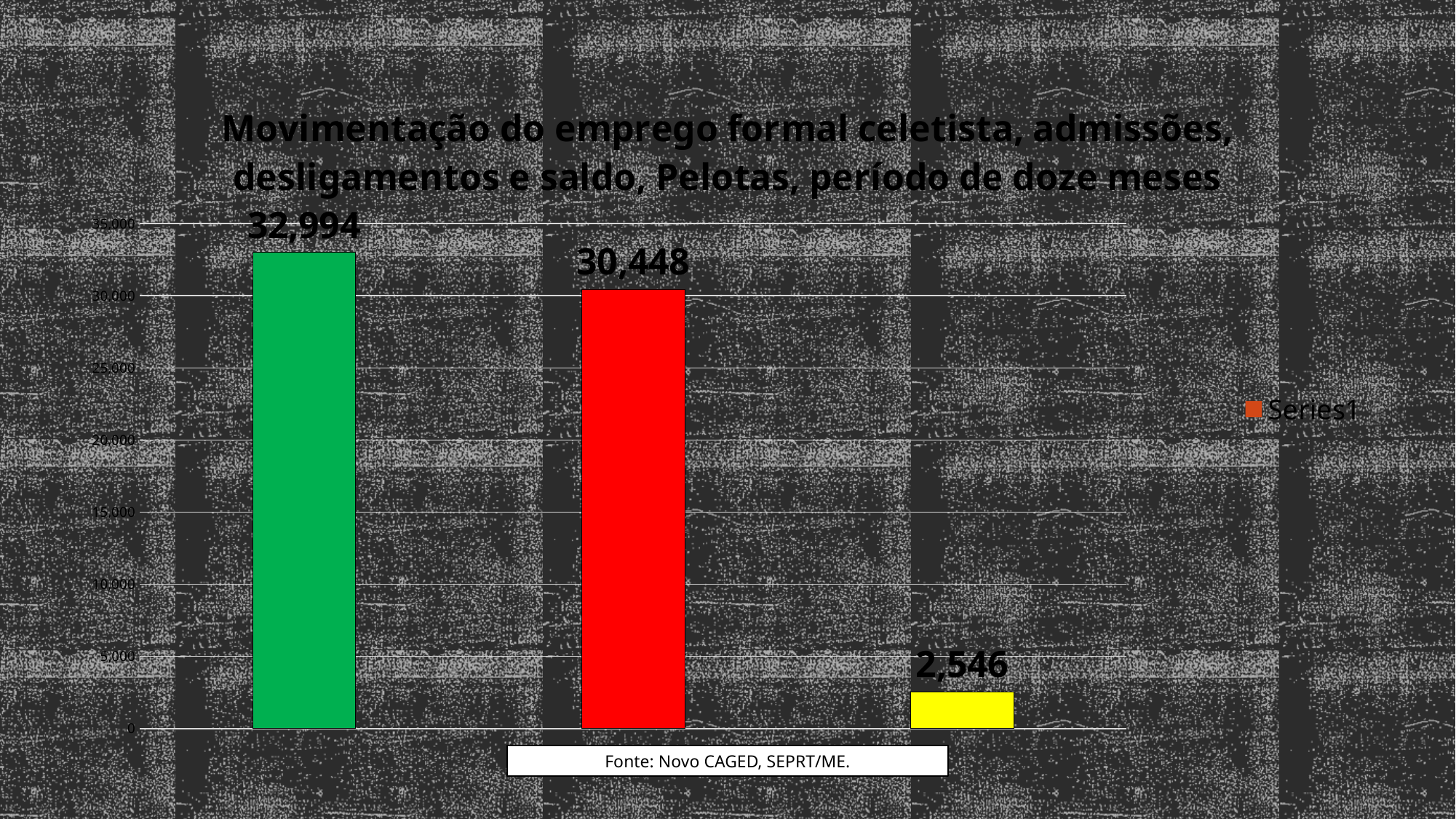
Is the value of the yellow bar greater or less than 5,000? less What is the name of the series listed in the legend? Series1 Which bar has the highest value: the green, red or yellow one? green What is the value shown on the yellow bar? 2,546 How many bars are plotted in the chart? 3 What kind of chart is shown on the slide? bar chart Which is larger, the value of the green bar or the value of the red bar? green bar What is the difference between the green bar's value and the red bar's value? 2,546 What is the value shown on the green bar? 32,994 What is the value shown on the red bar? 30,448 What is the difference between the red bar's value and the yellow bar's value? 27,902 Which bar has the lowest value: the green, red or yellow one? yellow